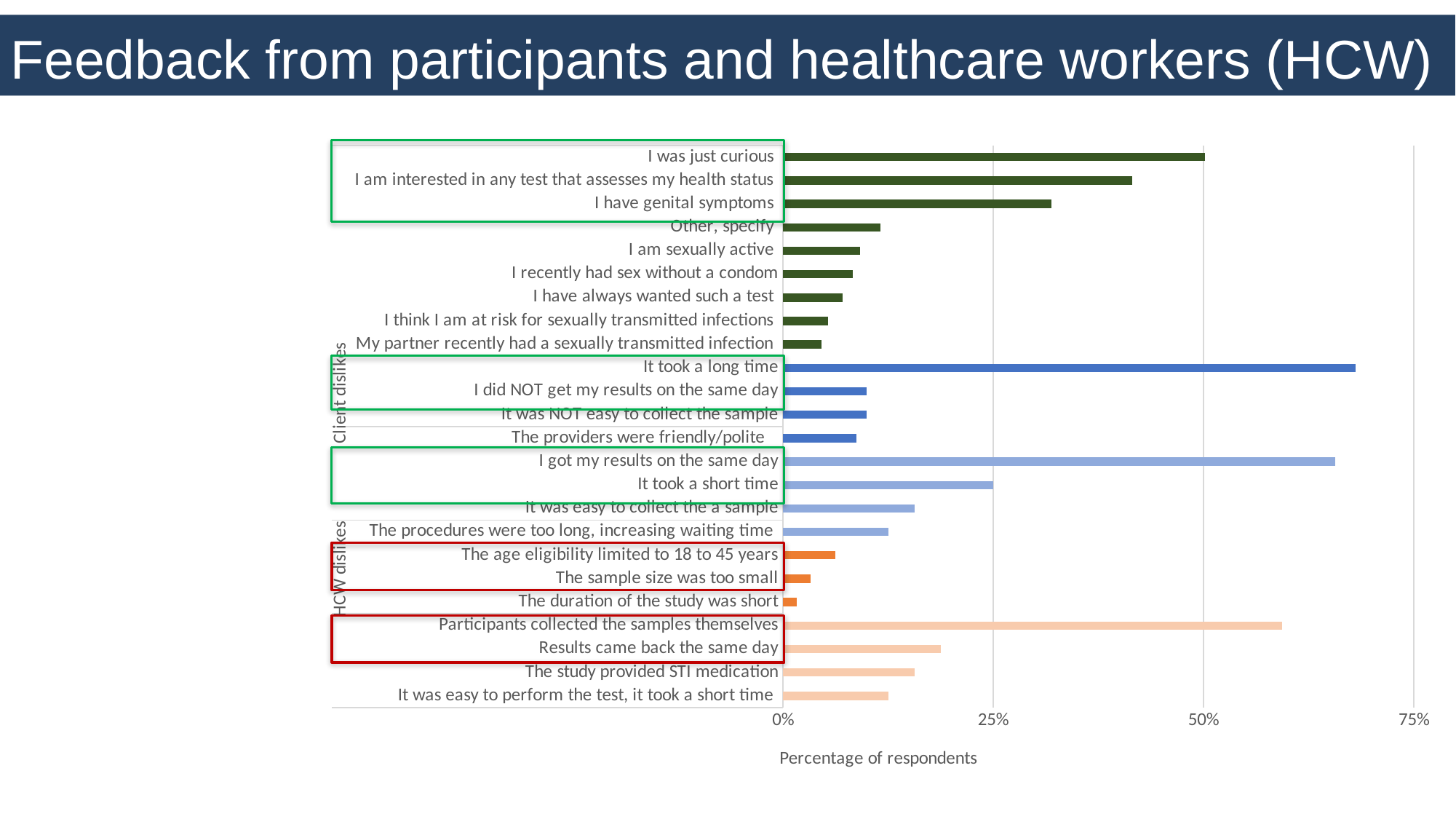
Is the value for "I am interested in any test that assesses my health status" greater or less than 50%? less Is the value for "Participants collected the samples themselves" greater or less than 50%? greater Is the value for "Results came back the same day" greater or less than 25%? less Which has a larger value: "I was just curious" or "I have genital symptoms"? I was just curious What is the title of the slide? Feedback from participants and healthcare workers (HCW) Among the dark orange bars, which category has the highest value? The age eligibility limited to 18 to 45 years What is the title of the horizontal axis? Percentage of respondents What kind of chart is shown on the slide? bar chart How many categories (bars) are plotted in the chart? 24 Which category has the lowest value in the chart? The duration of the study was short